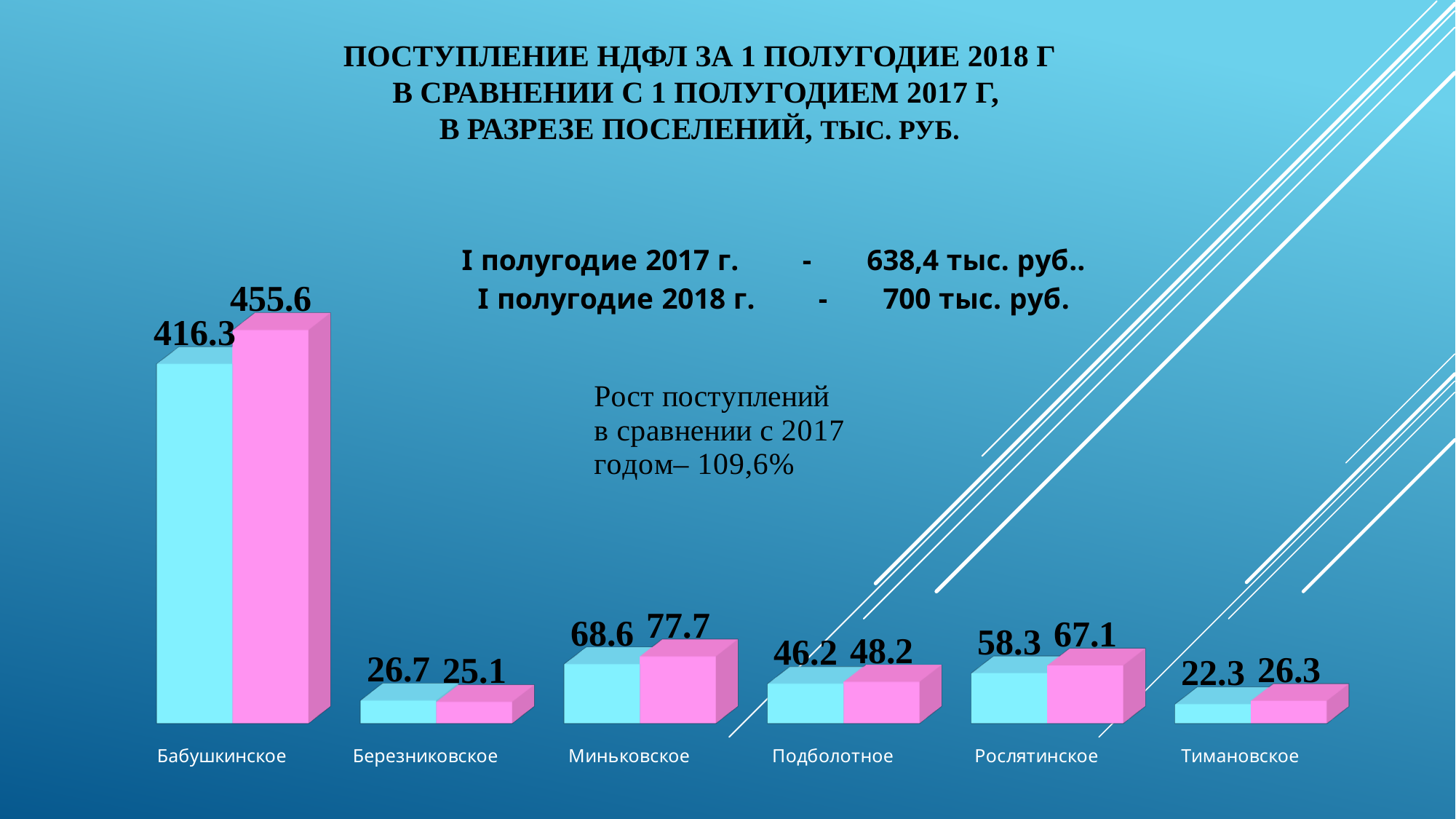
What unit of measurement is stated in the chart title? тыс. руб. What is the value of the pink bar for Бабушкинское? 455.6 What type of chart is shown on the slide? bar chart Which settlement has the lowest light blue bar value? Тимановское What is the value of the light blue bar for Рослятинское? 58.3 For Березниковское, which bar is larger: the light blue one or the pink one? the light blue one How many settlements (categories) are shown on the chart? 6 What is the difference between the pink and light blue bar values for Рослятинское? 8.8 What is the value of the light blue bar for Бабушкинское? 416.3 What is the value of the pink bar for Миньковское? 77.7 What is the difference between the pink and light blue bar values for Бабушкинское? 39.3 Which settlement has the highest pink bar value? Бабушкинское